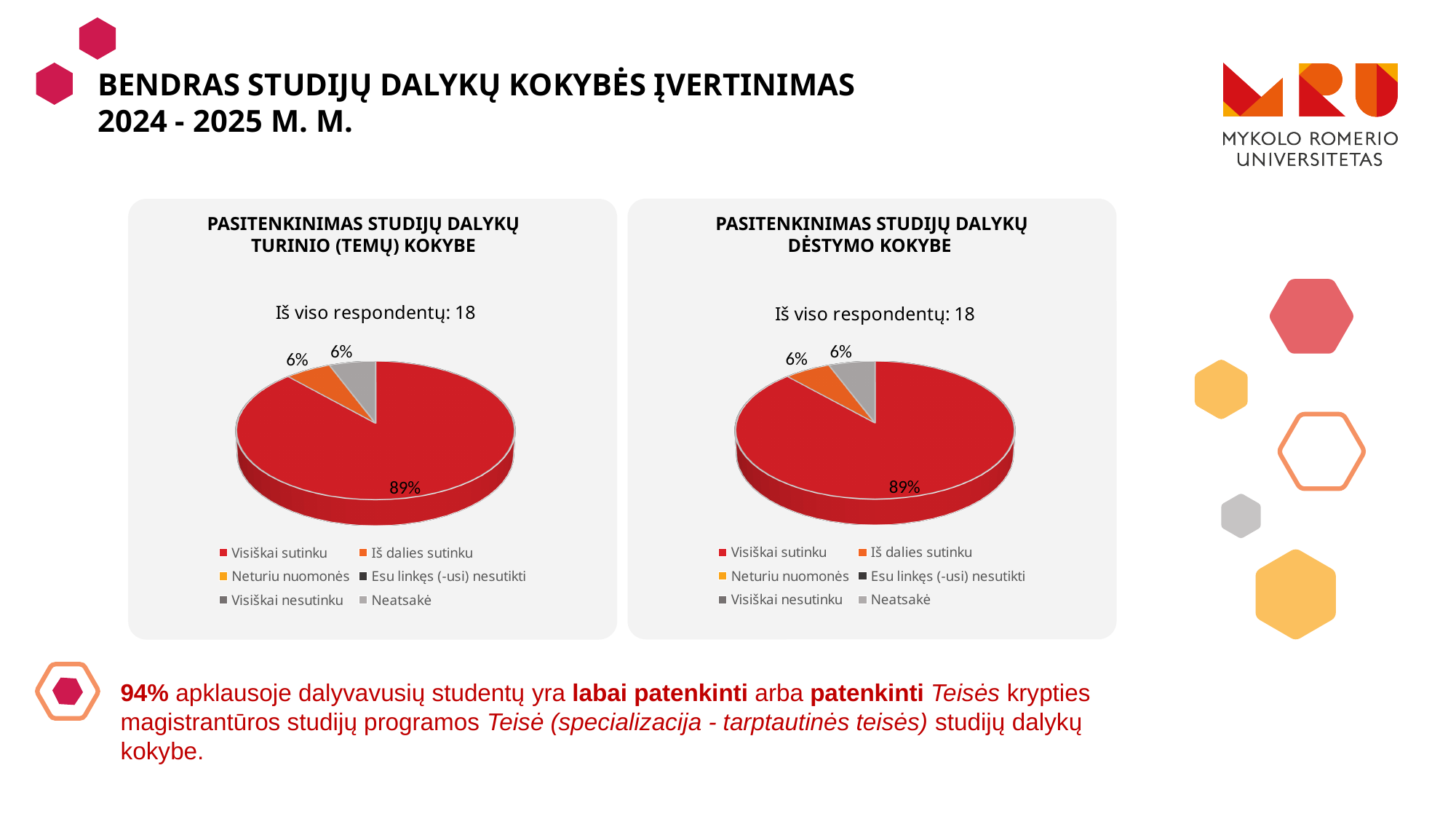
In the left chart (Pasitenkinimas studijų dalykų turinio (temų) kokybe), what share of respondents answered "Iš dalies sutinku"? 6% In the right chart (Pasitenkinimas studijų dalykų dėstymo kokybe), what share of respondents answered "Neatsakė"? 6% In the left chart (Pasitenkinimas studijų dalykų turinio (temų) kokybe), what is the difference in percentage points between the "Visiškai sutinku" slice and the "Iš dalies sutinku" slice? 83 percentage points How many entries does the legend of the right chart (Pasitenkinimas studijų dalykų dėstymo kokybe) list? 6 In the left chart (Pasitenkinimas studijų dalykų turinio (temų) kokybe), what share of respondents answered "Visiškai sutinku"? 89% What type of chart is used in the left chart (Pasitenkinimas studijų dalykų turinio (temų) kokybe)? Pie chart According to the left chart (Pasitenkinimas studijų dalykų turinio (temų) kokybe), how many respondents in total took part? 18 In the right chart (Pasitenkinimas studijų dalykų dėstymo kokybe), which is larger: the "Visiškai sutinku" slice or the "Neatsakė" slice? Visiškai sutinku In the right chart (Pasitenkinimas studijų dalykų dėstymo kokybe), which response category has the largest slice? Visiškai sutinku How many slices with data labels are shown in the left chart (Pasitenkinimas studijų dalykų turinio (temų) kokybe)? 3 In the left chart (Pasitenkinimas studijų dalykų turinio (temų) kokybe), which response category has the largest slice? Visiškai sutinku